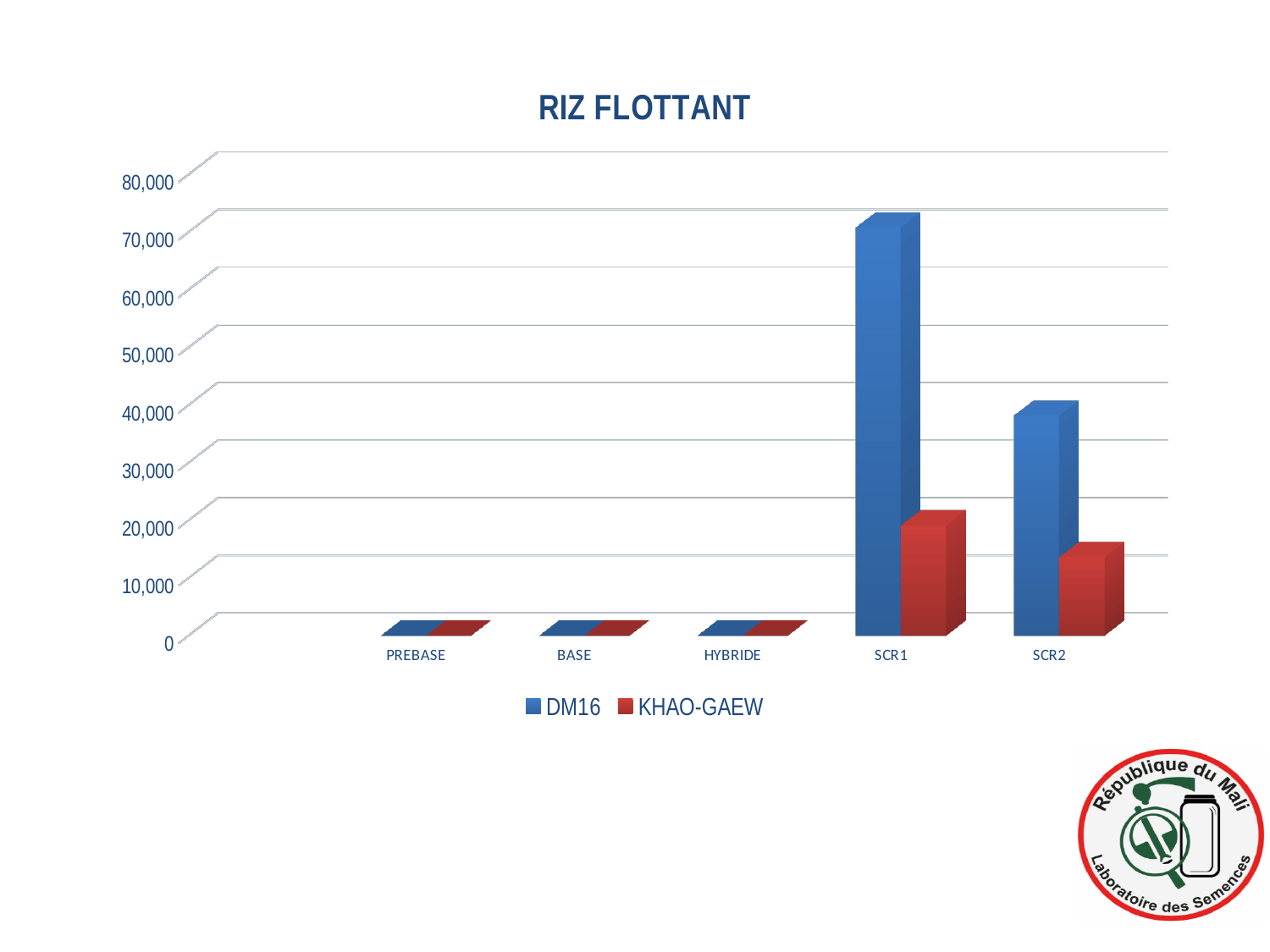
Which category has the highest value for DM16? SCR1 How many categories are shown on the x axis? 5 What is the title of the chart? RIZ FLOTTANT Is the DM16 value for SCR2 greater or less than 50,000? less Is the DM16 value for SCR1 greater or less than 60,000? greater Which colour represents the KHAO-GAEW series in the legend? red For SCR1, which series has the larger value, DM16 or KHAO-GAEW? DM16 What kind of chart is shown on the slide? bar chart Is the KHAO-GAEW value for SCR2 greater or less than 20,000? less Which category has the highest value for KHAO-GAEW? SCR1 How many series does the legend list? 2